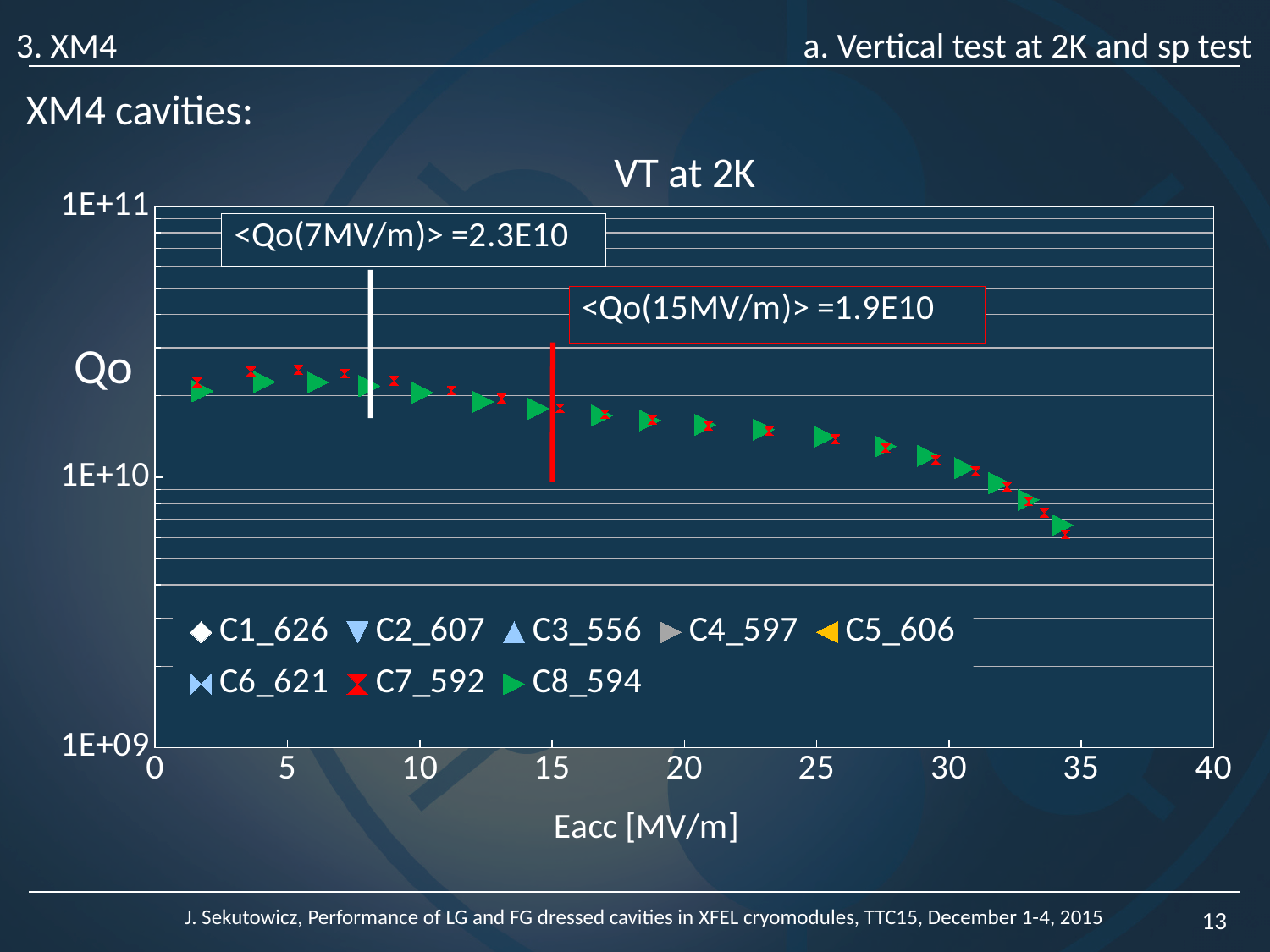
What is the label of the x axis? Eacc [MV/m] What is the highest value shown on the x axis? 40 What is the title of the chart? VT at 2K What average Qo value is given in the annotation for 15 MV/m? 1.9E10 Is the Qo value of the C8_594 series at about 5 MV/m greater or less than 1E+10? greater Is the average Qo at 7 MV/m larger or smaller than the average Qo at 15 MV/m? larger Do the plotted Qo values rise or fall as Eacc increases? fall Is the Qo value of the C8_594 series at about 34 MV/m greater or less than 1E+10? less What kind of chart is shown on the slide? scatter chart What is the lowest value shown on the Qo axis? 1E+09 How many series does the chart legend list? 8 What average Qo value is given in the annotation for 7 MV/m? 2.3E10